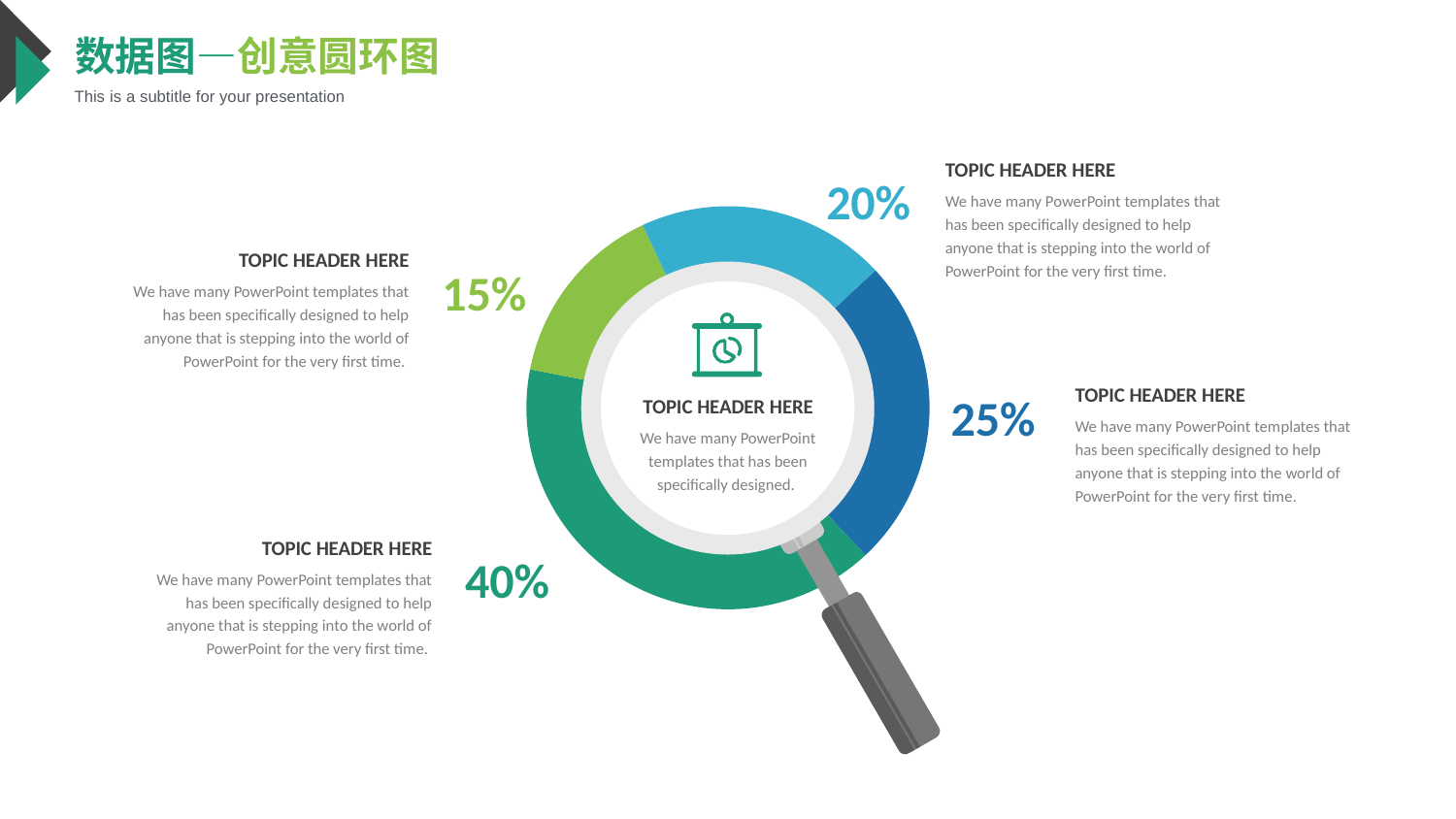
What percentage is labelled on the light green segment on the upper left of the donut chart? 15% How many segments does the donut chart have? 4 What do the four percentages on the donut chart add up to? 100% What kind of chart is shown on the slide? Donut chart What percentage is labelled on the large green segment at the bottom left of the donut chart? 40% Which segment is larger, the light blue one or the dark blue one? The dark blue one (25%) What is the smallest percentage shown on the donut chart? 15% What is the difference between the largest and smallest percentages on the donut chart? 25% What percentage is labelled on the light blue segment at the top of the donut chart? 20% What is the title of the slide? 数据图—创意圆环图 What percentage is labelled on the dark blue segment on the right of the donut chart? 25% What is the largest percentage shown on the donut chart? 40%